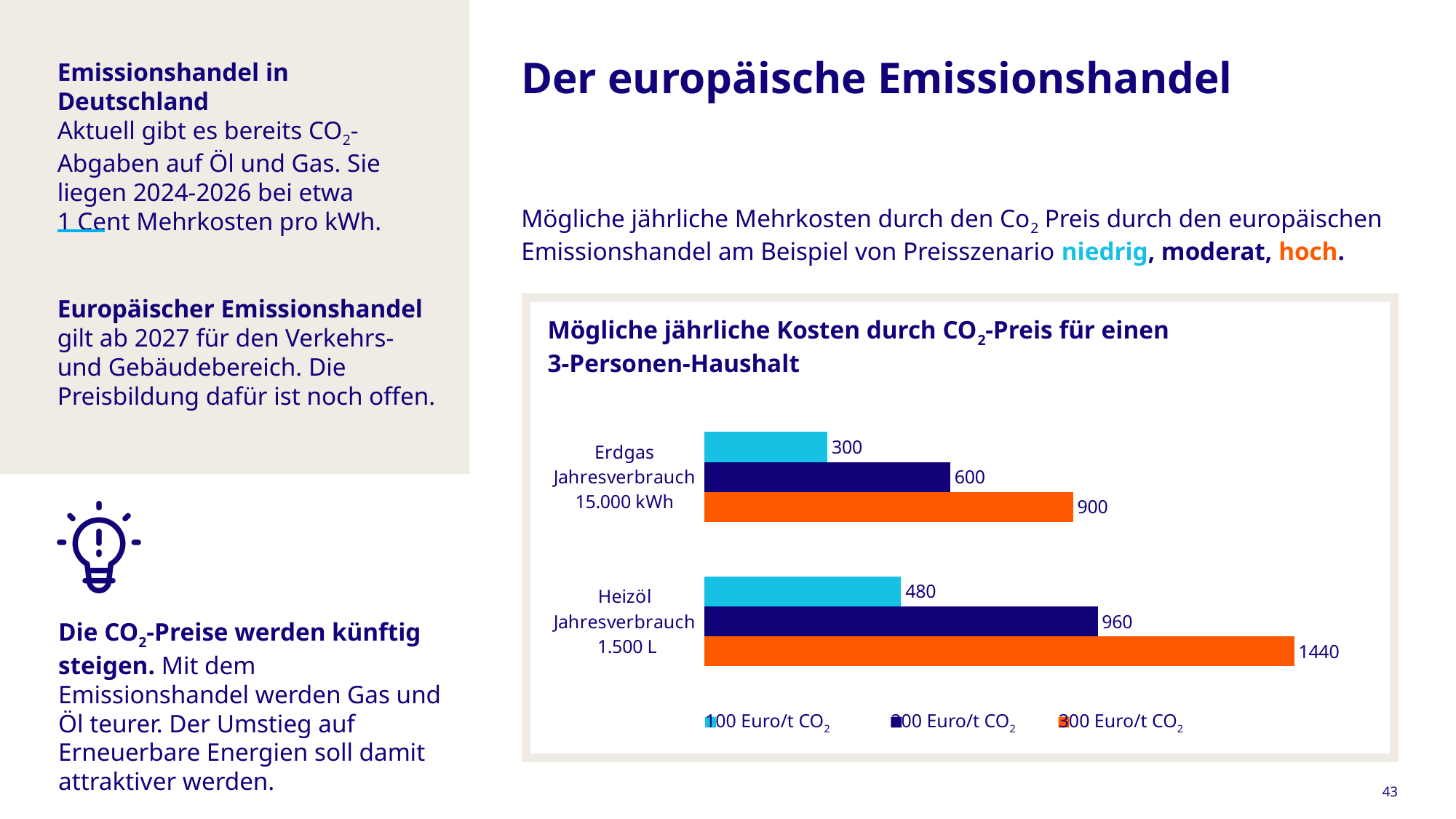
Which bar in the chart has the lowest value? Erdgas, 100 Euro/t CO2 (300) What kind of chart is shown on the slide? Bar chart How many categories are shown on the chart? 2 What is the value for Heizöl (Jahresverbrauch 1.500 L) in the 300 Euro/t CO2 series? 1440 How many series does the legend list? 3 What is the difference between the 200 Euro/t CO2 and 100 Euro/t CO2 values for Heizöl? 480 What is the value for Erdgas (Jahresverbrauch 15.000 kWh) in the 300 Euro/t CO2 series? 900 Which is larger: the 200 Euro/t CO2 value for Erdgas or the 100 Euro/t CO2 value for Heizöl? Erdgas, 200 Euro/t CO2 (600) What is the difference between the 300 Euro/t CO2 values for Heizöl and Erdgas? 540 What is the value for Heizöl (Jahresverbrauch 1.500 L) in the 200 Euro/t CO2 series? 960 What is the value for Erdgas (Jahresverbrauch 15.000 kWh) in the 100 Euro/t CO2 series? 300 Which bar in the chart has the highest value? Heizöl, 300 Euro/t CO2 (1440)